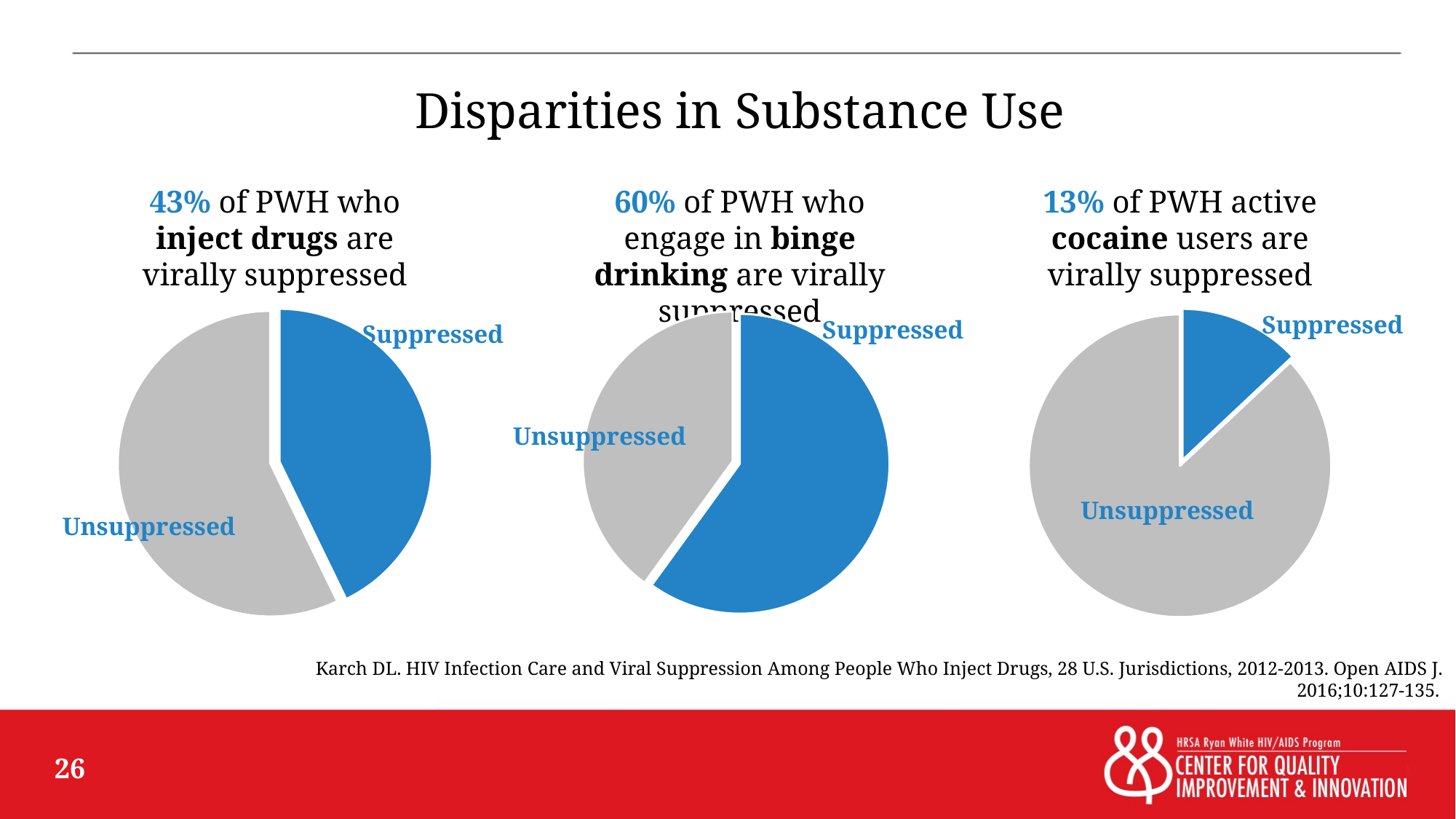
How many slices does each pie chart have? 2 Across the three pie charts, which group has the highest suppressed share? PWH who engage in binge drinking How many pie charts are on the slide? 3 In the right pie chart (PWH active cocaine users), which slice is smaller? Suppressed What is the difference between the suppressed share in the middle pie chart (binge drinking) and the right pie chart (cocaine users)? 47% In the middle pie chart (PWH who engage in binge drinking), what share is Suppressed? 60% In the left pie chart (PWH who inject drugs), what share is Suppressed? 43% In the left pie chart (PWH who inject drugs), which slice is larger, Suppressed or Unsuppressed? Unsuppressed What kind of charts are shown on the slide? Pie charts In the middle pie chart (PWH who engage in binge drinking), which slice is larger, Suppressed or Unsuppressed? Suppressed Across the three pie charts, which group has the lowest suppressed share? PWH active cocaine users In the right pie chart (PWH active cocaine users), what share is Suppressed? 13%